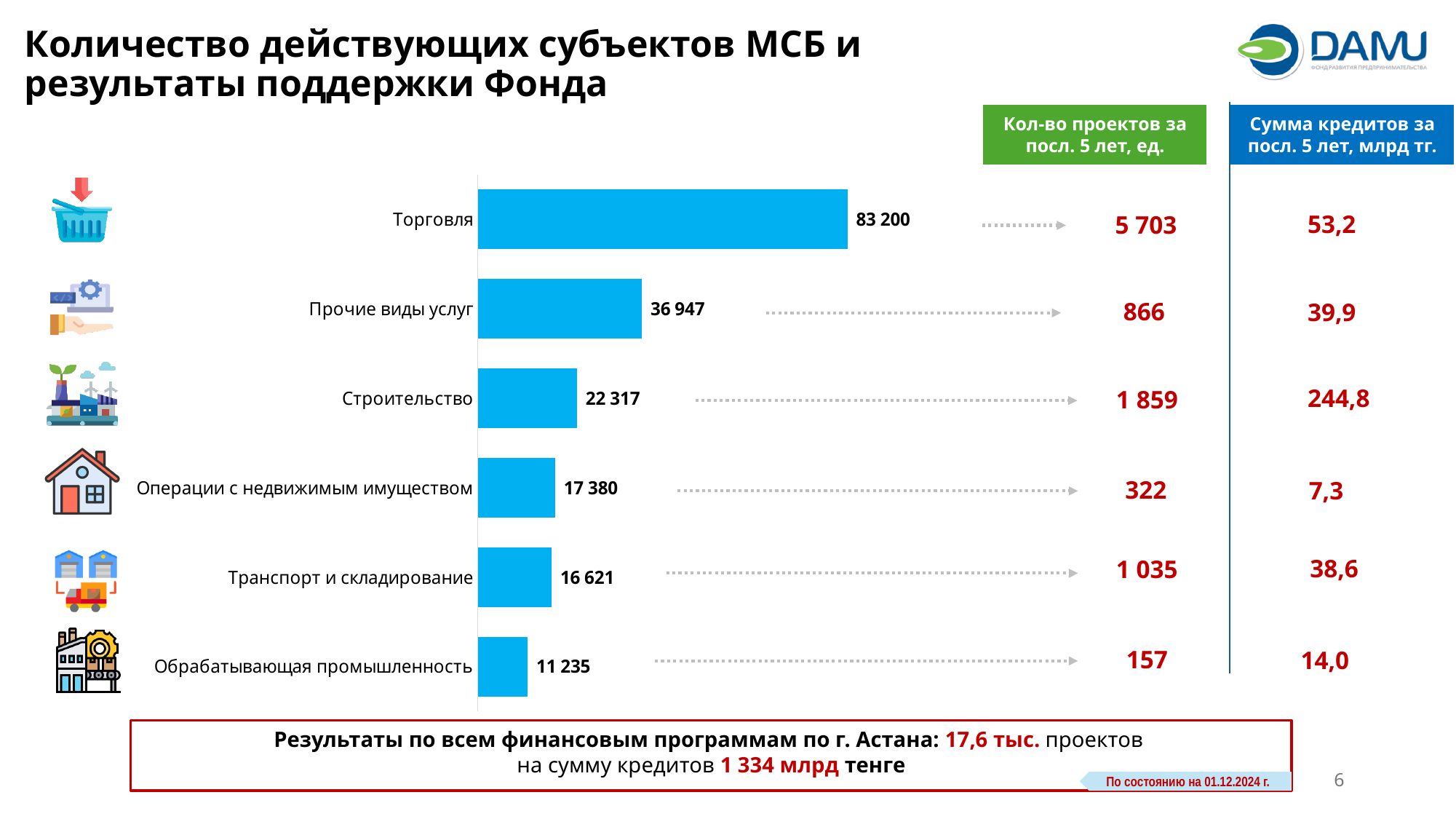
Which is larger: the value for Операции с недвижимым имуществом or the value for Транспорт и складирование? Операции с недвижимым имуществом What is the difference between the values for Торговля and Прочие виды услуг? 46 253 What is the difference between the values for Строительство and Операции с недвижимым имуществом? 4 937 What colour are the bars in the chart? Blue How many categories are shown in the bar chart? 6 What kind of chart is shown on the slide? Bar chart Which category has the highest value in the bar chart? Торговля What is the value shown for Строительство? 22 317 What is the value shown for Обрабатывающая промышленность? 11 235 Which category has the lowest value in the bar chart? Обрабатывающая промышленность What is the value shown for Торговля? 83 200 What is the value shown for Прочие виды услуг? 36 947